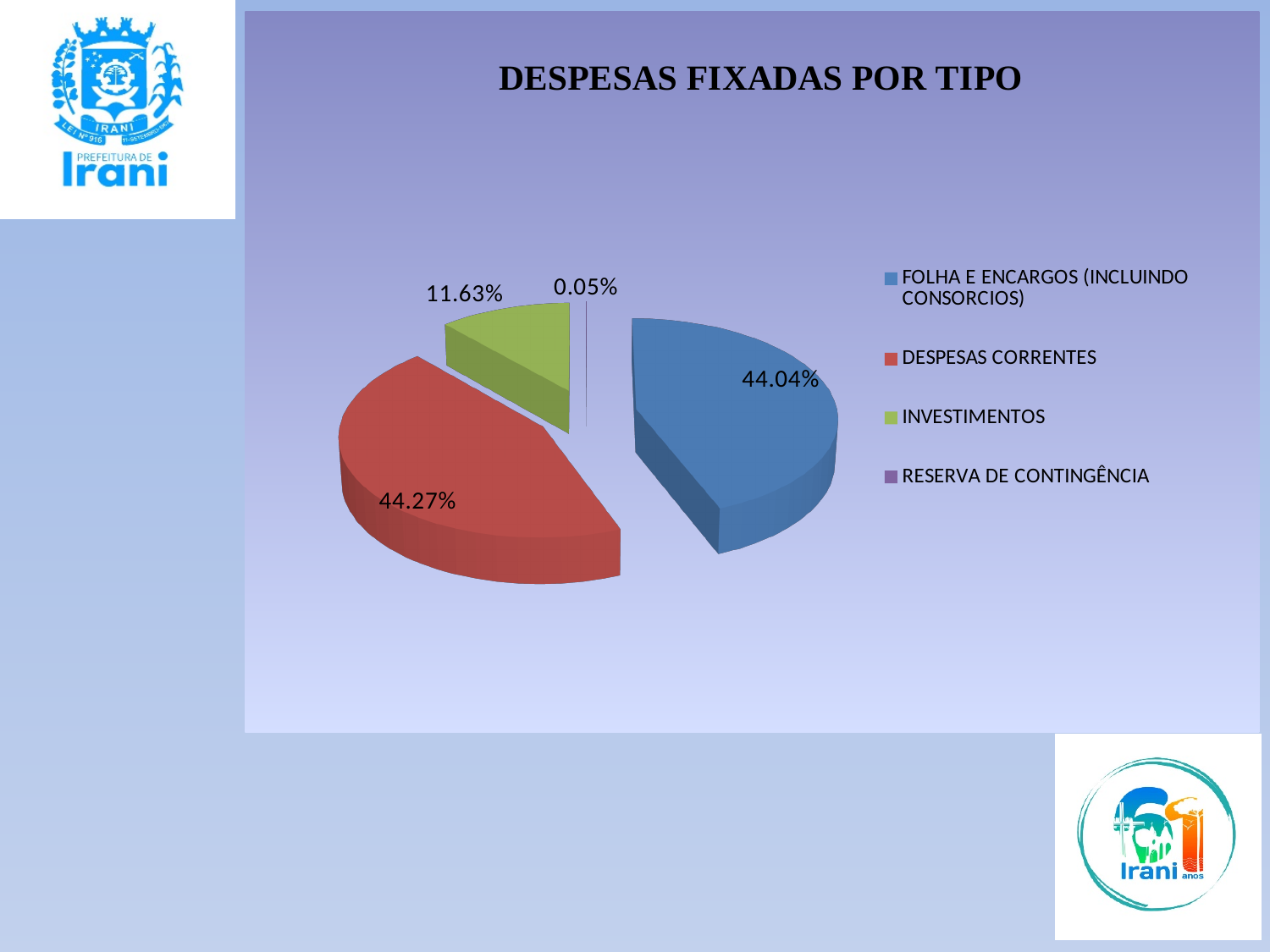
What kind of chart is shown on the slide? Pie chart Which category has the largest share of the pie? DESPESAS CORRENTES What is the title of the chart? DESPESAS FIXADAS POR TIPO What percentage is shown for FOLHA E ENCARGOS (INCLUINDO CONSORCIOS)? 44.04% What is the value labelled for INVESTIMENTOS? 11.63% Which category has the smallest share of the pie? RESERVA DE CONTINGÊNCIA Which is larger, the share for INVESTIMENTOS or the share for RESERVA DE CONTINGÊNCIA? INVESTIMENTOS What percentage is shown for RESERVA DE CONTINGÊNCIA? 0.05% What is the difference between the shares of FOLHA E ENCARGOS (INCLUINDO CONSORCIOS) and INVESTIMENTOS? 32.41% What share of the pie does DESPESAS CORRENTES represent? 44.27% What is the difference between the shares of DESPESAS CORRENTES and FOLHA E ENCARGOS (INCLUINDO CONSORCIOS)? 0.23% How many categories are shown in the pie chart? 4